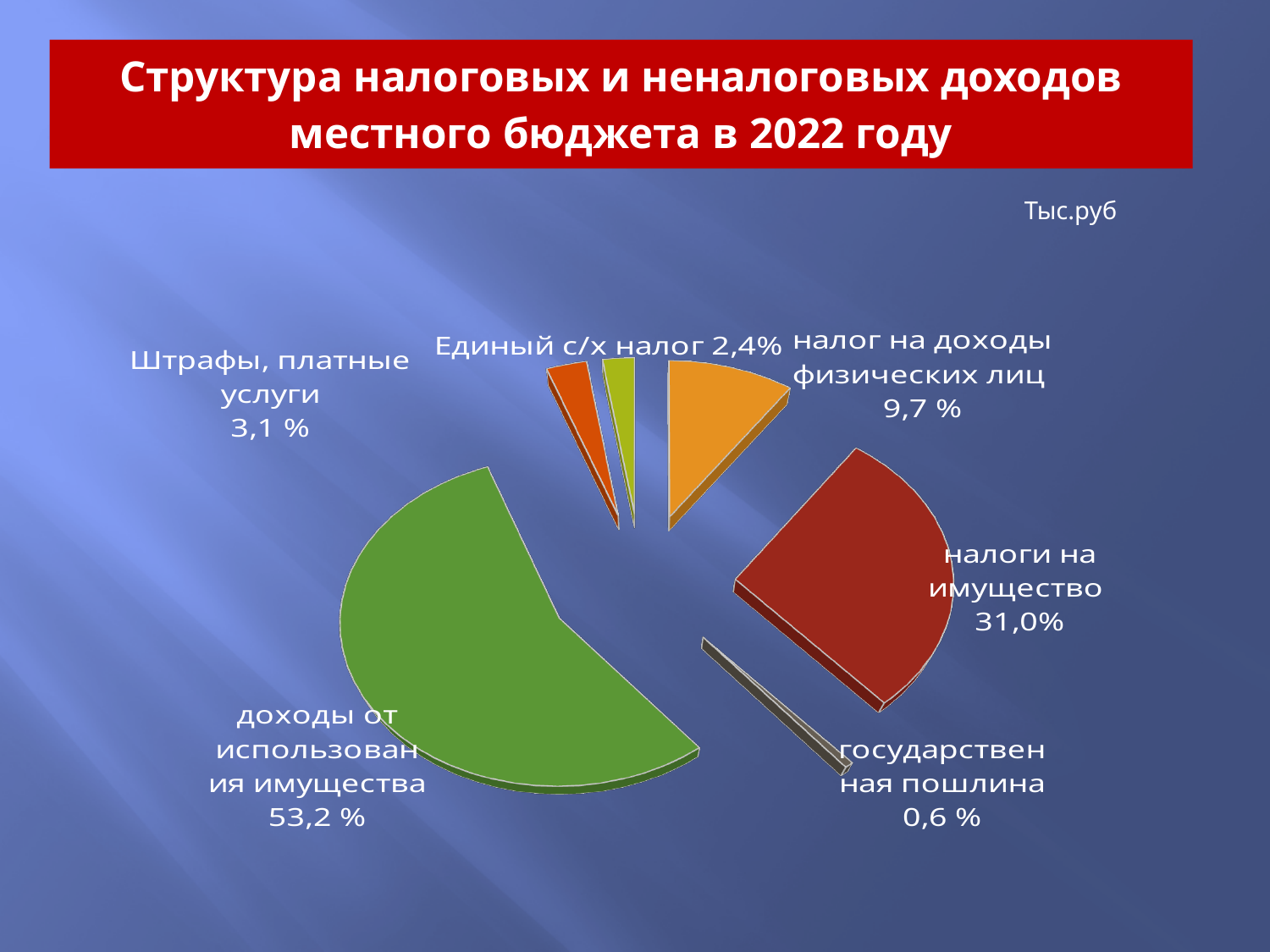
What is the difference in percentage points between "доходы от использования имущества" and "налоги на имущество"? 22,2 What kind of chart is shown on the slide? pie chart What share is shown for "Единый с/х налог"? 2,4% What share of the pie is labelled for "доходы от использования имущества"? 53,2 % Which is larger: the share for "налоги на имущество" or the share for "налог на доходы физических лиц"? налоги на имущество Which category has the largest share of the pie? доходы от использования имущества Which category has the smallest share of the pie? государственная пошлина What share is shown for "государственная пошлина"? 0,6 % How many slices does the pie chart have? 6 What share is shown for "Штрафы, платные услуги"? 3,1 % What share is shown for "налог на доходы физических лиц"? 9,7 % What share is shown for "налоги на имущество"? 31,0%